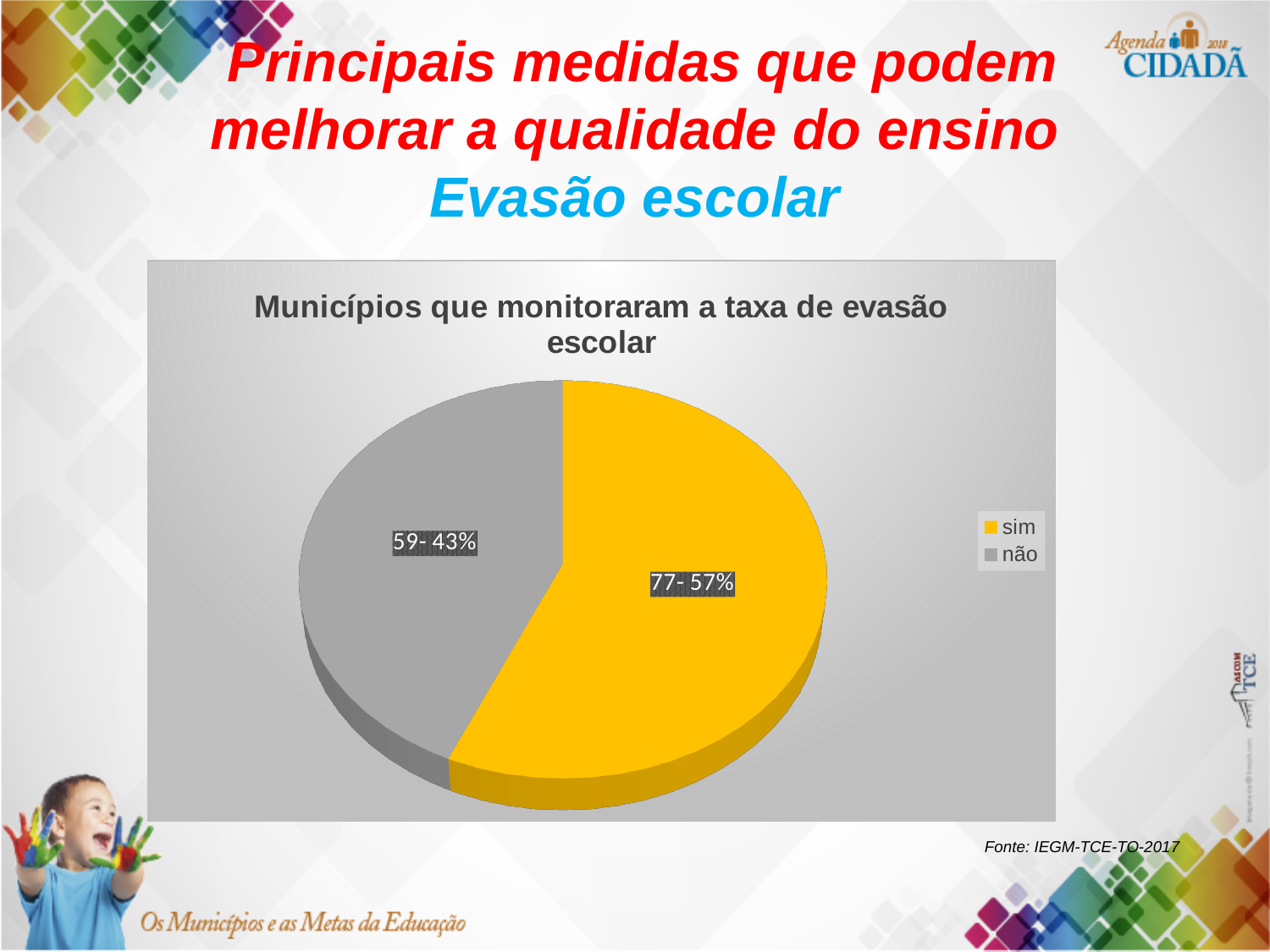
What is the difference in number of municipalities between 'sim' and 'não'? 18 What share of the pie does the 'sim' slice represent? 57% How many municipalities are in the 'sim' slice? 77 How many entries does the legend list? 2 Which slice is the largest? sim How many slices does the pie chart have? 2 How many municipalities are in the 'não' slice? 59 Which colour represents the 'não' slice? grey Which slice is the smallest? não What share of the pie does the 'não' slice represent? 43% What kind of chart is shown on the slide? pie chart What is the title of the chart? Municípios que monitoraram a taxa de evasão escolar